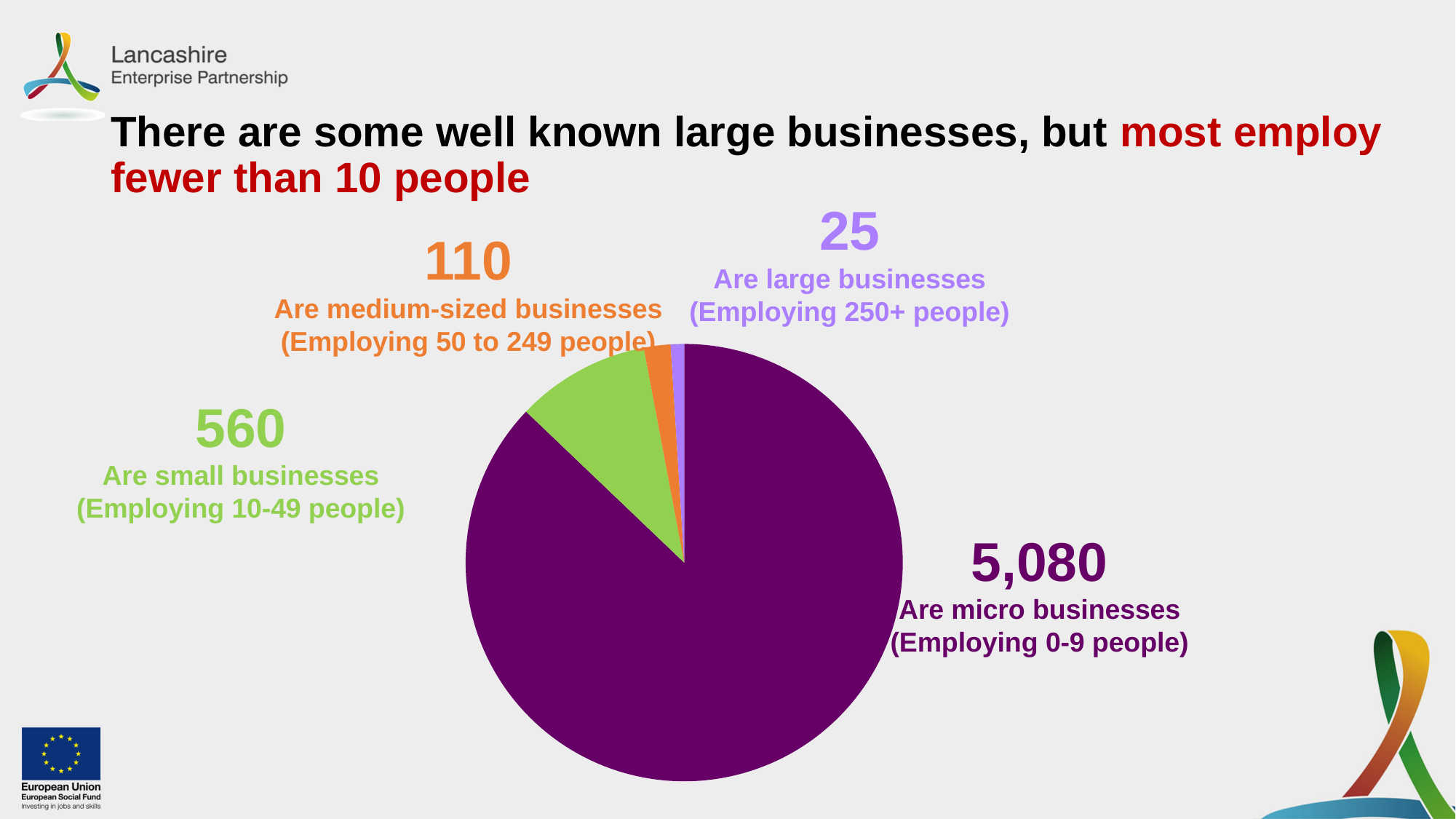
What kind of chart is shown on the slide? Pie chart How many small businesses (employing 10-49 people) are shown on the pie chart? 560 Which is larger: the number of small businesses or the number of medium-sized businesses? Small businesses What is the difference between the number of medium-sized businesses and the number of large businesses? 85 What is the difference between the number of micro businesses and the number of small businesses? 4,520 How many large businesses (employing 250+ people) are shown on the pie chart? 25 What colour is the slice representing micro businesses? Purple Which business size category has the smallest slice of the pie chart? Large businesses (Employing 250+ people) How many business size categories are shown in the pie chart? 4 Which business size category has the largest slice of the pie chart? Micro businesses (Employing 0-9 people) How many micro businesses (employing 0-9 people) are shown on the pie chart? 5,080 How many medium-sized businesses (employing 50 to 249 people) are shown on the pie chart? 110